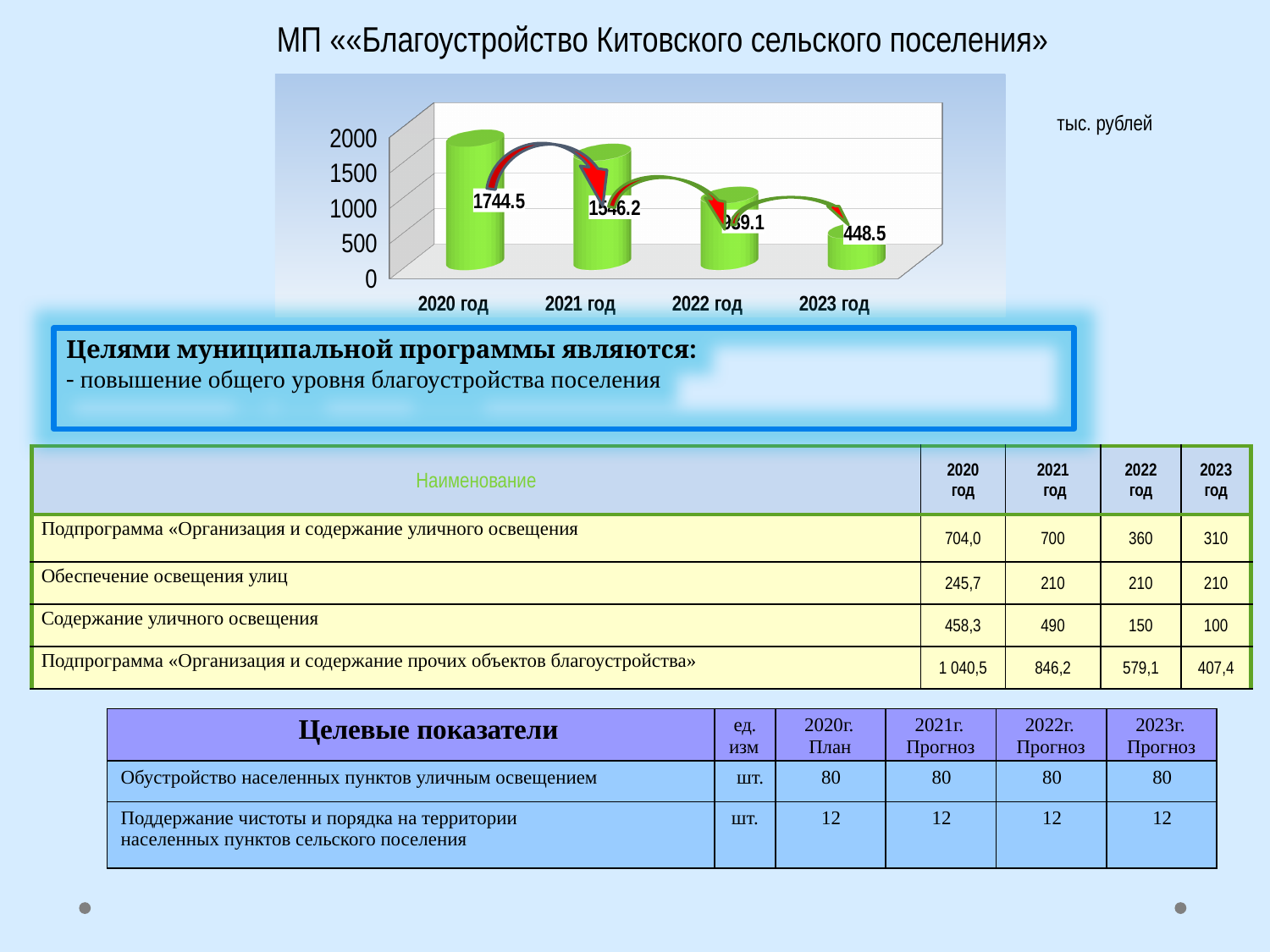
How many years are shown on the x axis of the chart? 4 Which year has the highest value in the chart? 2020 год What is the difference between the values for 2020 год and 2023 год in the chart? 1296 What is the value for 2020 год in the chart? 1744.5 What kind of chart is shown on the slide? bar chart Is the value for 2021 год in the chart greater or less than 1000? greater Which year has the lowest value in the chart? 2023 год In what units are the chart values given, according to the label next to the chart? тыс. рублей Is the value for 2022 год in the chart greater or less than 1000? less Do the values in the chart rise or fall from 2020 год to 2023 год? fall Which is larger in the chart, the value for 2021 год or the value for 2022 год? 2021 год What is the value for 2023 год in the chart? 448.5